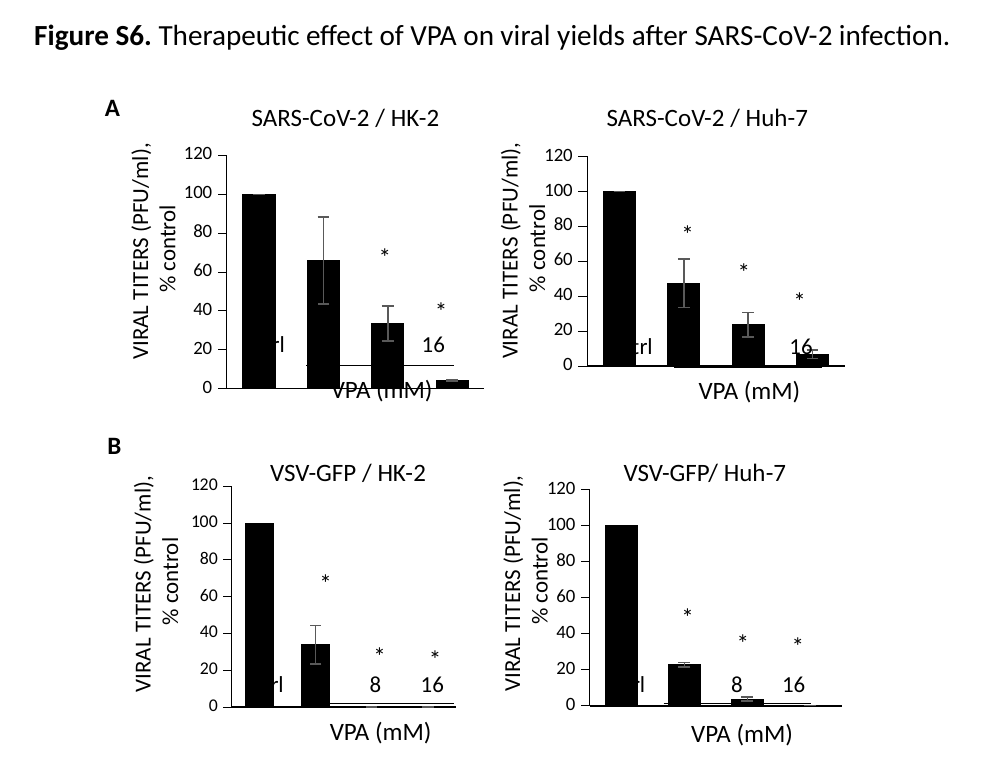
In the SARS-CoV-2 / Huh-7 chart, which bar is the highest? ctrl In the SARS-CoV-2 / HK-2 chart, which is larger, the value for 8 mM VPA or the value for 16 mM VPA? 8 mM In the VSV-GFP / Huh-7 chart, do the viral titers rise or fall as the VPA concentration increases along the x axis? fall What is the x-axis title of the VSV-GFP / HK-2 chart? VPA (mM) What is the y-axis title of the SARS-CoV-2 / HK-2 chart? VIRAL TITERS (PFU/ml), % control How many bars are plotted in the SARS-CoV-2 / HK-2 chart? 4 In the VSV-GFP / HK-2 chart, is the value for 8 mM VPA greater or less than 20? less What kind of chart is the SARS-CoV-2 / HK-2 chart? bar chart In the VSV-GFP / Huh-7 chart, is the value for 8 mM VPA greater or less than 20? less In the SARS-CoV-2 / Huh-7 chart, is the value for 16 mM VPA greater or less than 20? less In the SARS-CoV-2 / Huh-7 chart, what is the value of the ctrl bar? 100